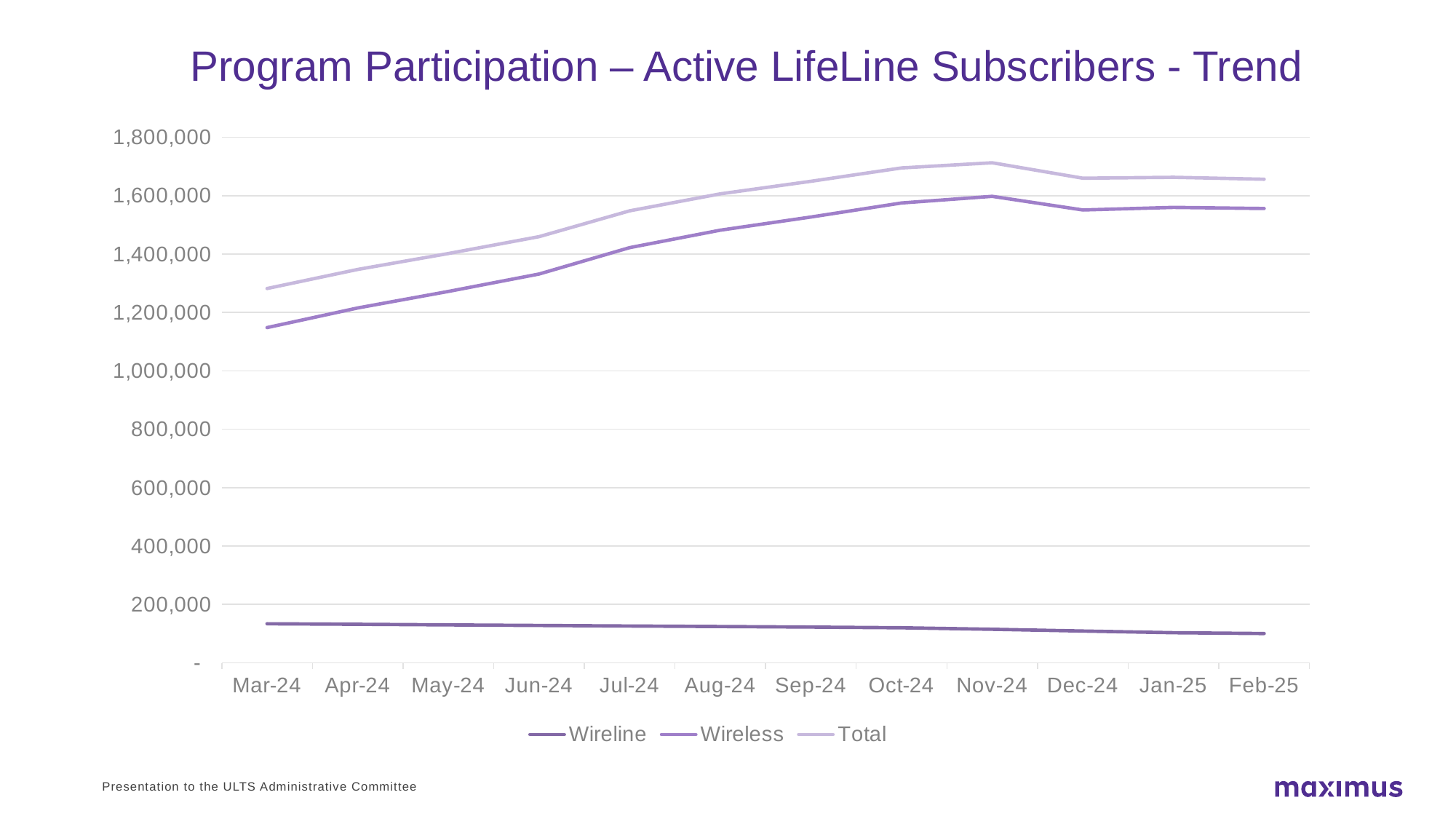
Which series is higher in Jun-24, Wireless or Wireline? Wireless In which month does the Total series reach its highest value? Nov-24 Is the Total value for Mar-24 greater or less than 1,200,000? greater In which month is the Wireline series at its lowest value? Feb-25 Is the Wireline value for Feb-25 greater or less than 200,000? less What kind of chart is shown on the slide? Line chart Is the Wireless value for Mar-24 greater or less than 1,200,000? less In which month does the Wireless series reach its highest value? Nov-24 How many series does the legend list? 3 Does the Wireline series rise or fall from Mar-24 to Feb-25? Fall How many months are plotted along the x axis? 12